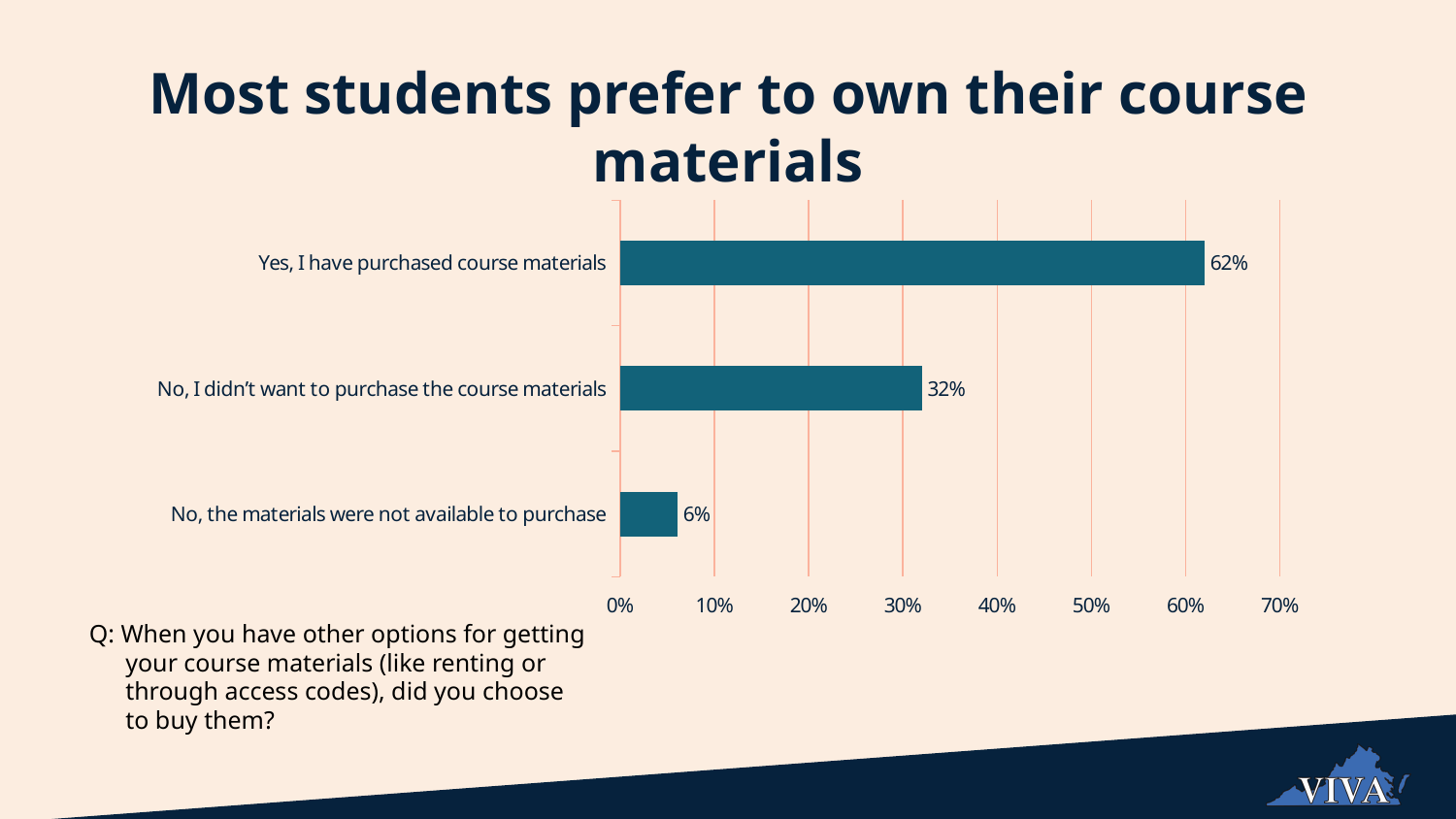
Which response has the lowest percentage? No, the materials were not available to purchase Which response has the highest percentage? Yes, I have purchased course materials Which is larger: the percentage for "No, I didn't want to purchase the course materials" or for "No, the materials were not available to purchase"? No, I didn't want to purchase the course materials What is the difference in percentage points between "Yes, I have purchased course materials" and "No, I didn't want to purchase the course materials"? 30 percentage points What is the difference in percentage points between "No, I didn't want to purchase the course materials" and "No, the materials were not available to purchase"? 26 percentage points Is the value for "Yes, I have purchased course materials" greater or less than 50%? greater What percentage of students said "Yes, I have purchased course materials"? 62% What percentage of students said "No, the materials were not available to purchase"? 6% What kind of chart is shown on the slide? Bar chart How many response categories are shown in the chart? 3 What percentage of students said "No, I didn't want to purchase the course materials"? 32% What is the title of the slide containing the chart? Most students prefer to own their course materials